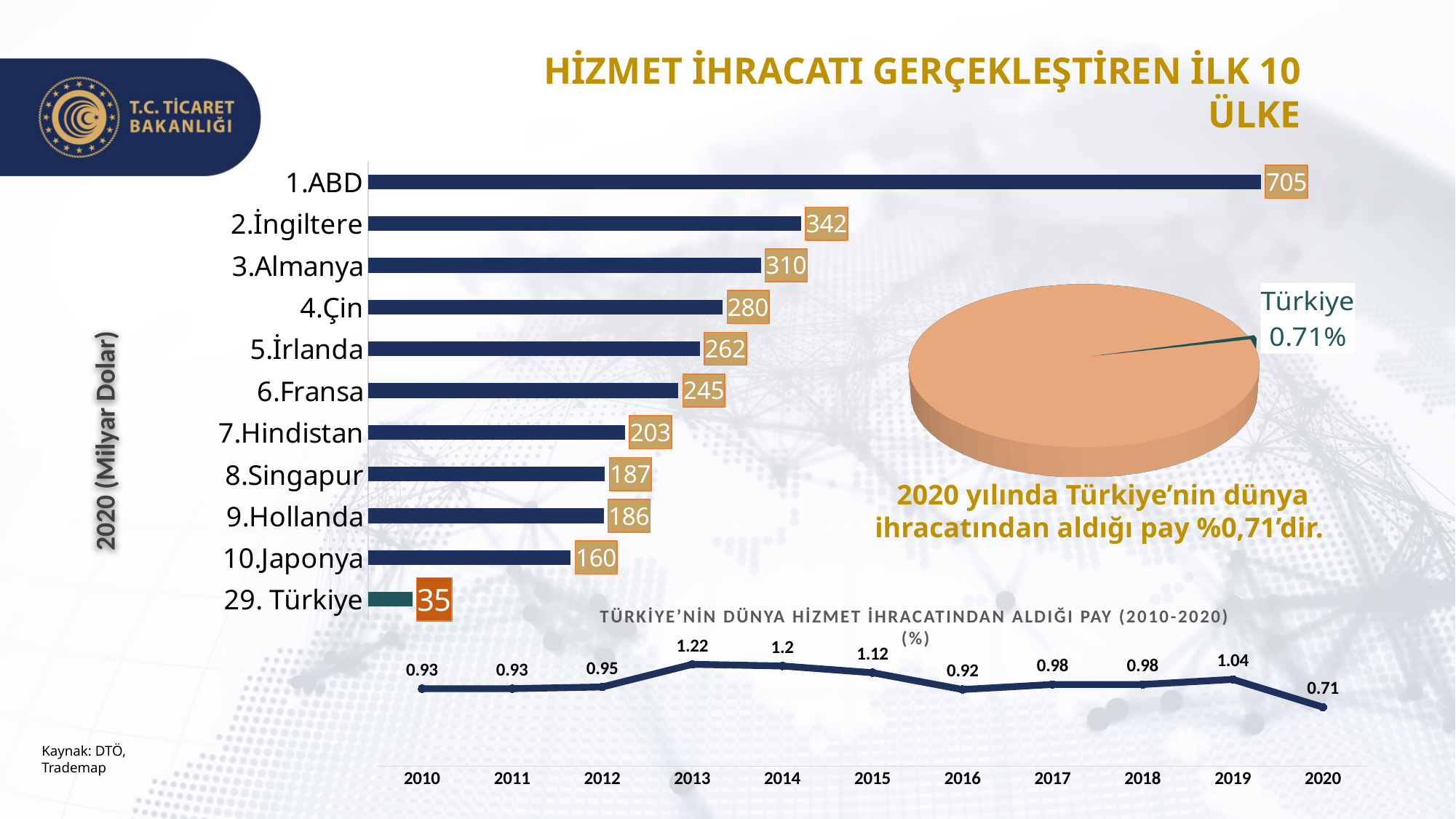
What kind of chart is the chart 'HİZMET İHRACATI GERÇEKLEŞTİREN İLK 10 ÜLKE'? Bar chart In the pie chart on the right, what share does Türkiye have? 0.71% In the bar chart 'HİZMET İHRACATI GERÇEKLEŞTİREN İLK 10 ÜLKE', what is the difference between 2.İngiltere and 3.Almanya? 32 In the line chart 'TÜRKİYE'NİN DÜNYA HİZMET İHRACATINDAN ALDIĞI PAY (2010-2020)', what is the value for 2013? 1.22 How many countries are shown in the bar chart 'HİZMET İHRACATI GERÇEKLEŞTİREN İLK 10 ÜLKE'? 11 In the bar chart 'HİZMET İHRACATI GERÇEKLEŞTİREN İLK 10 ÜLKE', which country has the highest value? 1.ABD In the line chart 'TÜRKİYE'NİN DÜNYA HİZMET İHRACATINDAN ALDIĞI PAY (2010-2020)', which year has the lowest value? 2020 In the bar chart 'HİZMET İHRACATI GERÇEKLEŞTİREN İLK 10 ÜLKE', what is the value for 1.ABD? 705 In the line chart 'TÜRKİYE'NİN DÜNYA HİZMET İHRACATINDAN ALDIĞI PAY (2010-2020)', does the value rise or fall from 2019 to 2020? Fall In the bar chart 'HİZMET İHRACATI GERÇEKLEŞTİREN İLK 10 ÜLKE', which is larger, 7.Hindistan or 10.Japonya? 7.Hindistan In the bar chart 'HİZMET İHRACATI GERÇEKLEŞTİREN İLK 10 ÜLKE', what is the value for 5.İrlanda? 262 In the bar chart 'HİZMET İHRACATI GERÇEKLEŞTİREN İLK 10 ÜLKE', what is the value for 29. Türkiye? 35